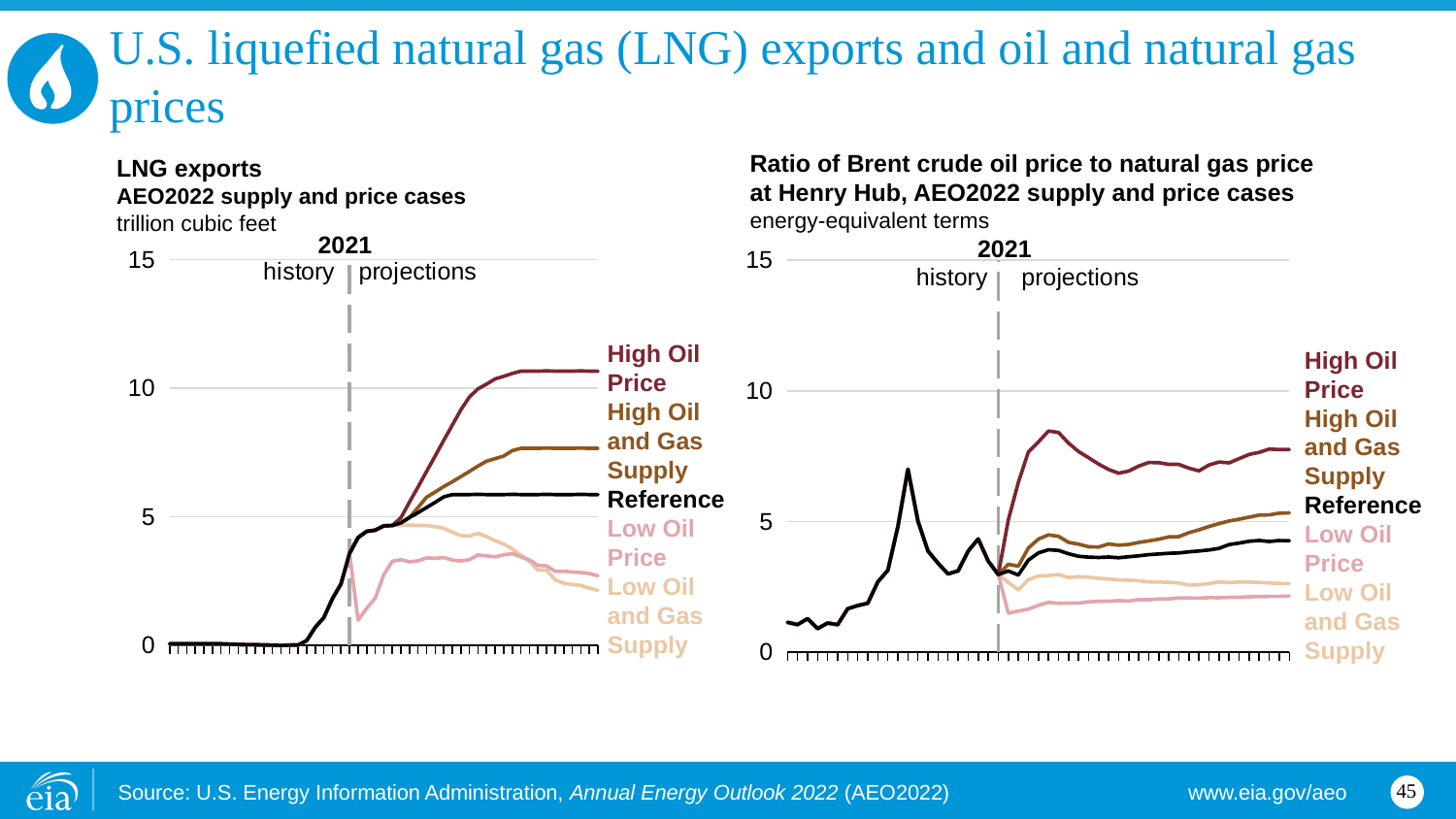
On the LNG exports chart, do the Low Oil Price values rise or fall over the later projection years? fall On the Ratio of Brent crude oil price to natural gas price chart, which case has the highest value at the end of the projection period? High Oil Price On the Ratio of Brent crude oil price to natural gas price chart, is the High Oil Price value at the end of the projection period greater or less than 5? greater On the LNG exports chart, is the High Oil Price value at the end of the projection period greater or less than 10 trillion cubic feet? greater On the LNG exports chart, which case has the lowest value at the end of the projection period? Low Oil and Gas Supply On the LNG exports chart, which is larger at the end of the projection period: High Oil and Gas Supply or Reference? High Oil and Gas Supply What year separates history from projections on both charts? 2021 How many series (cases) are labeled on the LNG exports chart? 5 What kind of chart is the LNG exports chart on the left? line chart On the LNG exports chart, is the Reference case value at the end of the projection period greater or less than 5 trillion cubic feet? greater On the LNG exports chart, which case has the highest value at the end of the projection period? High Oil Price